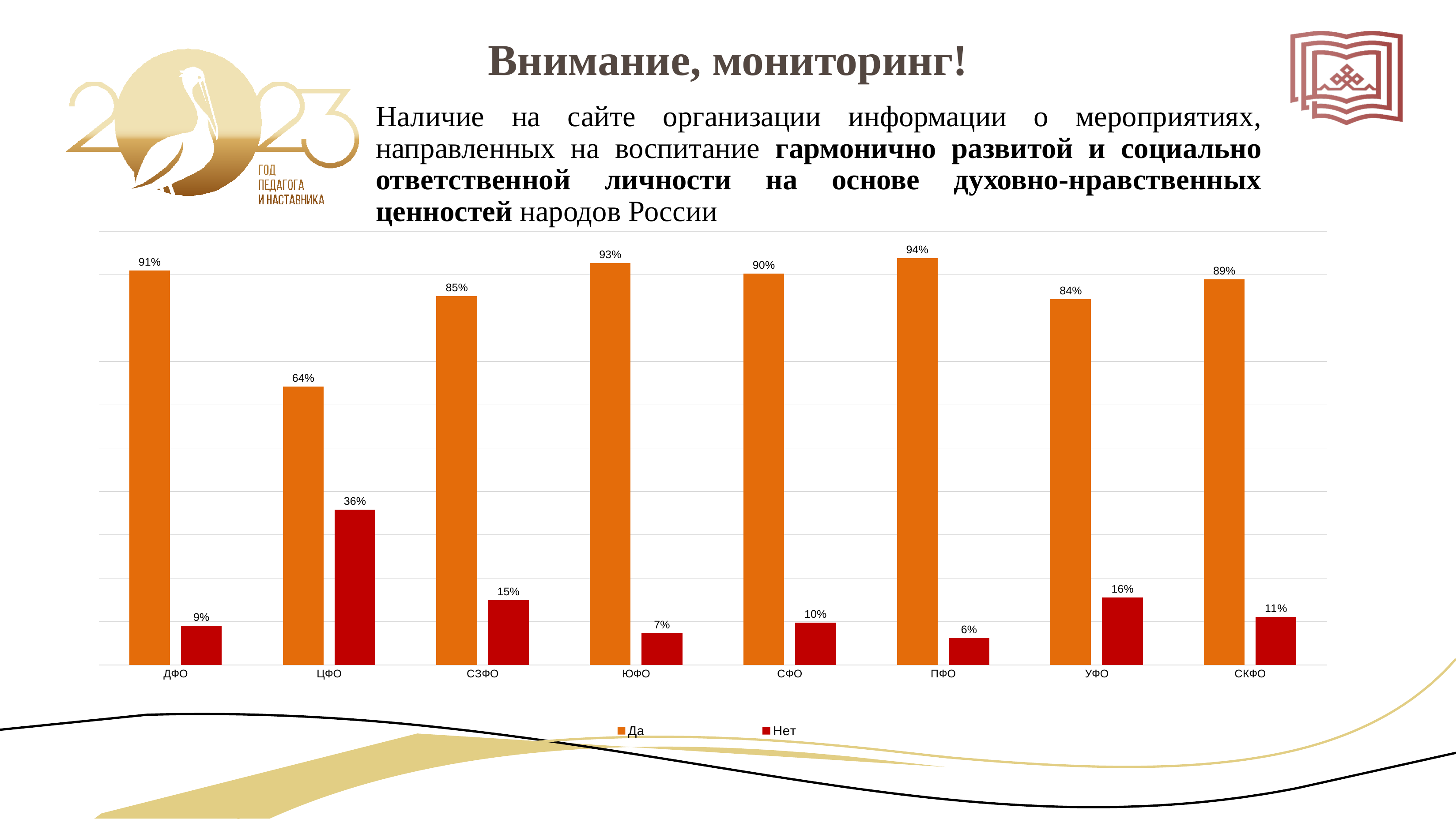
How many series does the legend list? 2 What is the value of the "Да" series for СКФО? 89% What is the difference between the "Да" values for ЮФО and СЗФО? 8% Which category has the lowest "Нет" value? ПФО Which category has the highest "Да" value? ПФО Which is larger: the "Нет" value for СЗФО or for СКФО? СЗФО What kind of chart is shown on the slide? Bar chart Which category has the highest "Нет" value? ЦФО What colour are the bars of the "Нет" series? Red What is the value of the "Нет" series for УФО? 16% How many categories are shown on the x axis? 8 What is the value of the "Да" series for ЦФО? 64%